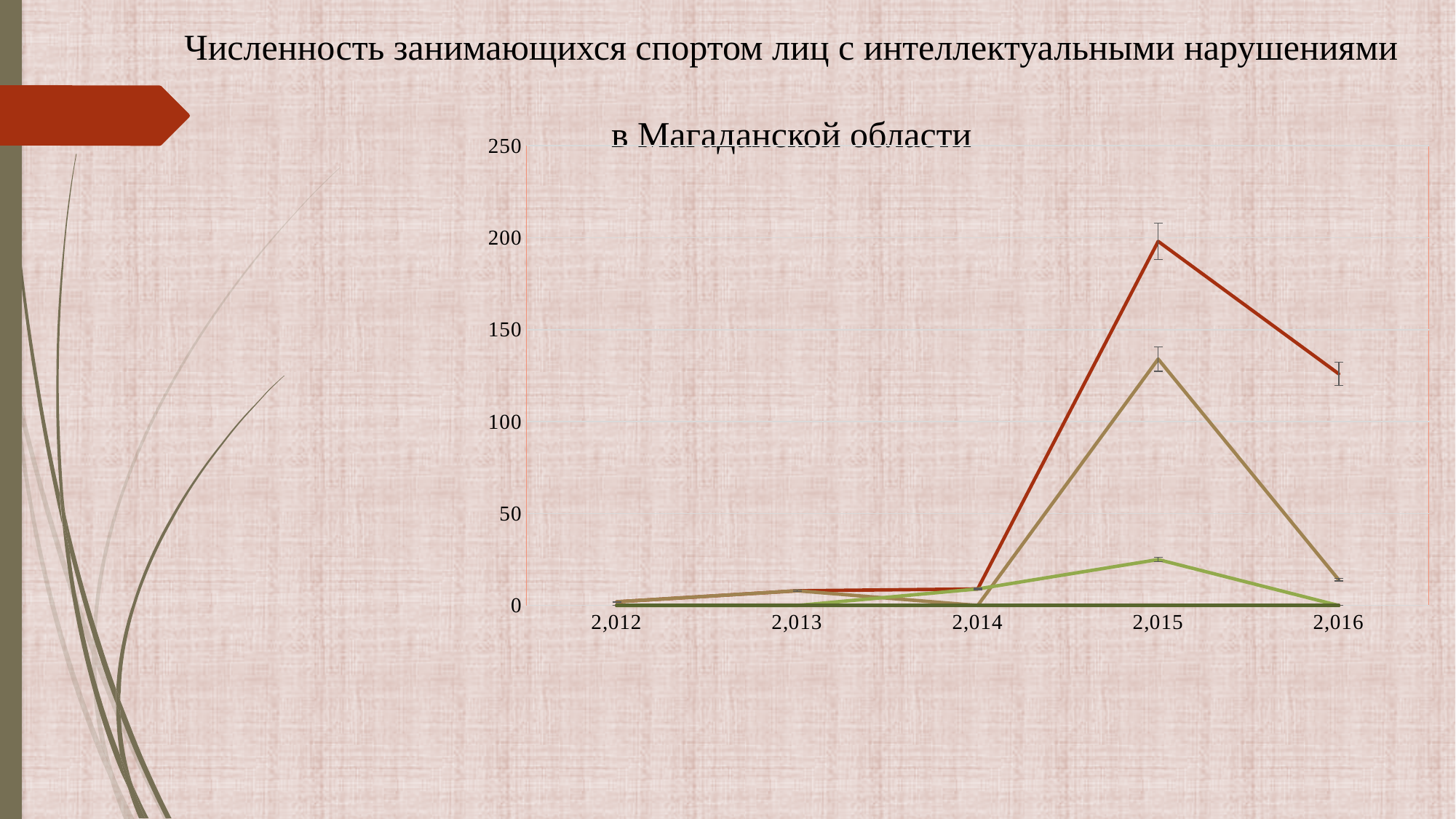
Is the value of the tan (brown) line in 2,016 greater or less than 50? less Is the value of the red line in 2,015 greater or less than 150? greater Is the value of the tan (brown) line in 2,015 greater or less than 100? greater What kind of chart is shown on the slide? line chart Does the red line rise or fall from 2,015 to 2,016? fall What is the title of the chart? Численность занимающихся спортом лиц с интеллектуальными нарушениями в Магаданской области In which year does the red line reach its highest value? 2,015 How many years are shown on the x axis of the chart? 5 What is the highest value shown on the y axis of the chart? 250 In 2,015, which line has the larger value, the red line or the tan (brown) line? the red line